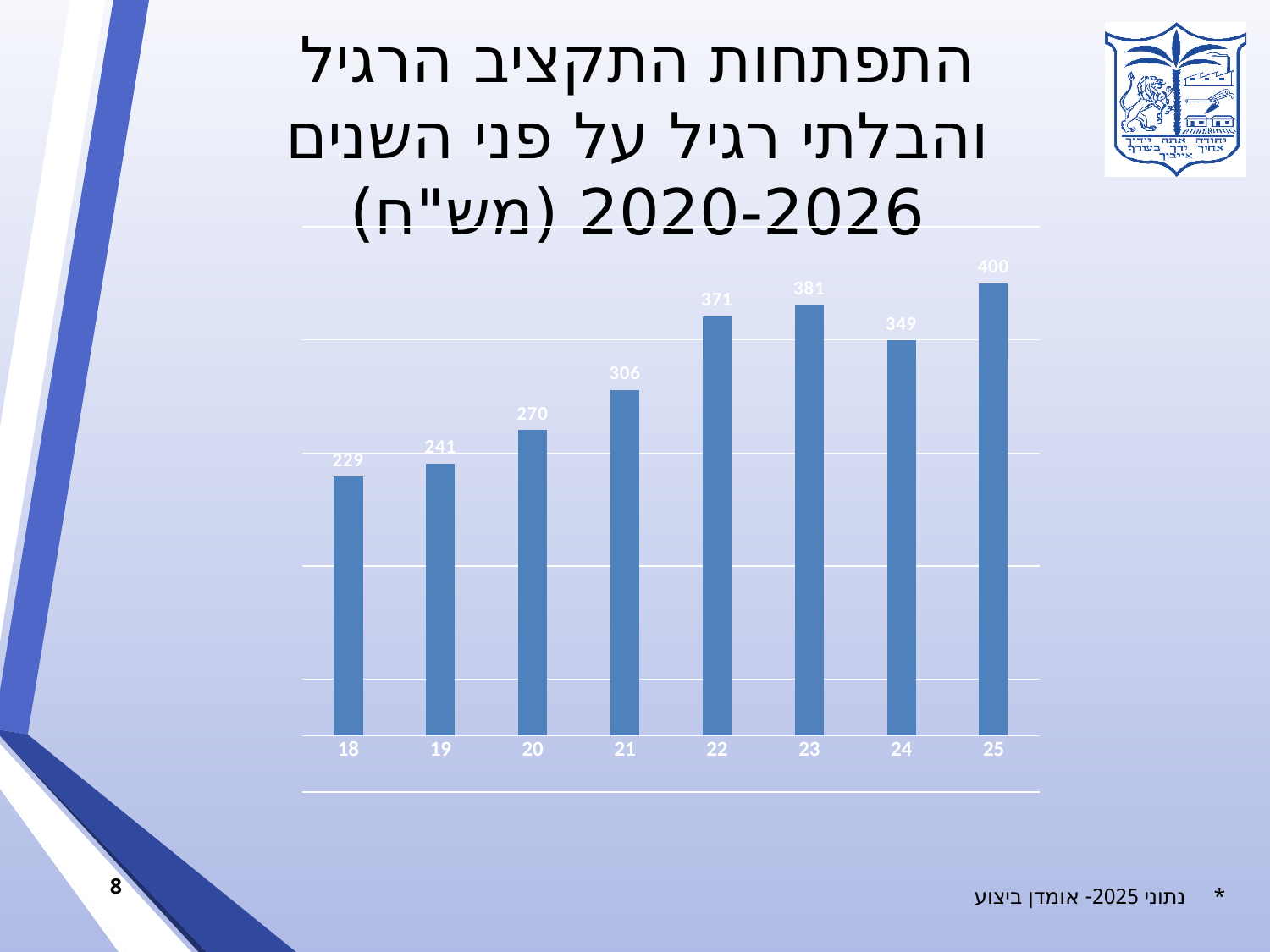
What is the value for category 18? 229 What is the value for category 24? 349 Which category has the highest value? 25 What is the difference between the values for 23 and 24? 32 Which category has the lowest value? 18 What kind of chart is shown on the slide? bar chart What is the difference between the values for 25 and 18? 171 How many categories are shown on the x axis? 8 What is the value for category 20? 270 Which is larger, the value for 22 or the value for 24? 22 What is the value for category 21? 306 Do the values generally rise or fall from category 18 to category 23? rise